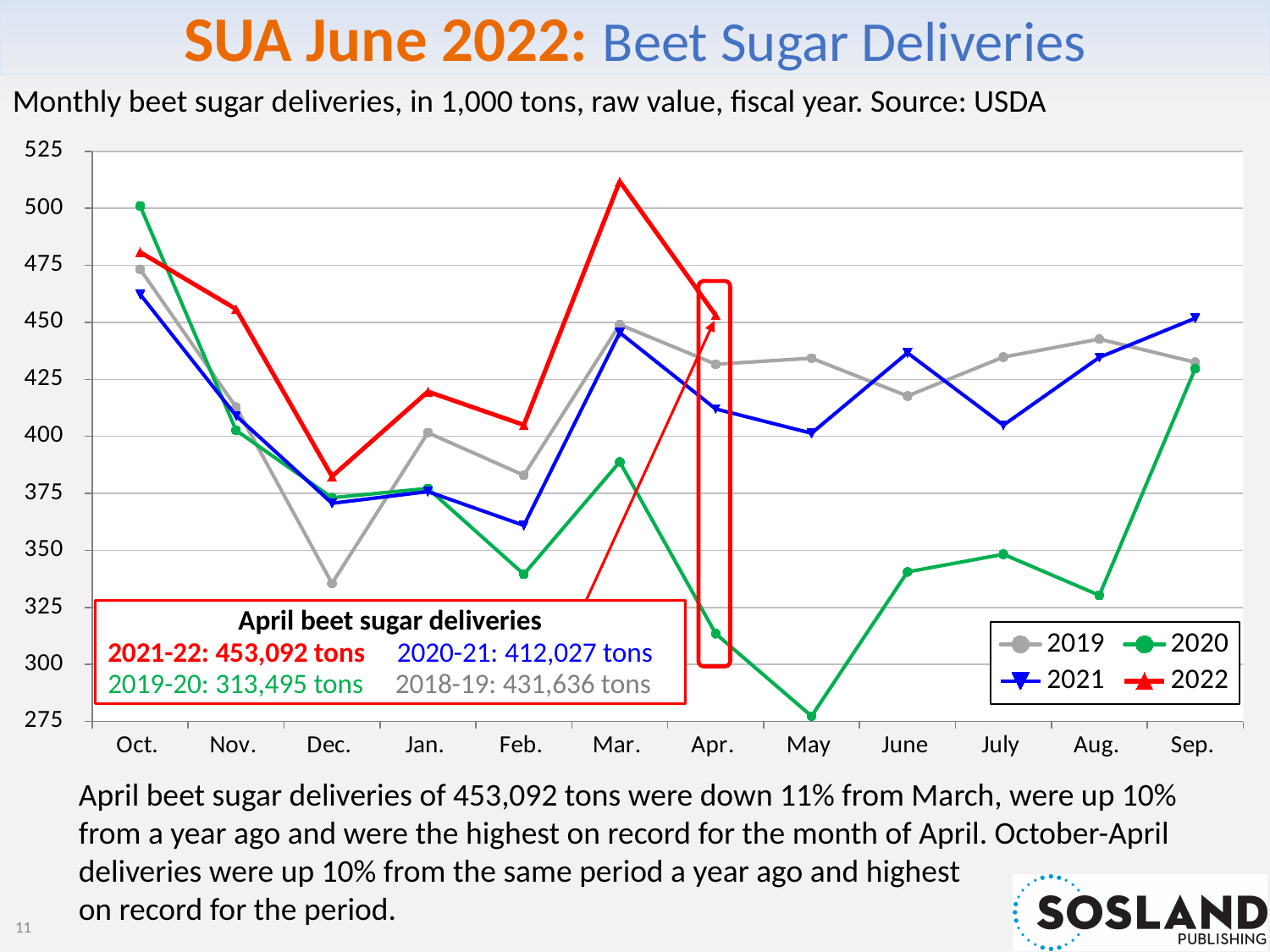
In which month does the 2020 series reach its lowest value? May Is the value for the 2022 series in March greater or less than 500? greater According to the annotation box, what were April beet sugar deliveries in 2021-22? 453,092 tons Does the 2022 series rise or fall from October to December? fall According to the annotation box, what were April beet sugar deliveries in 2019-20? 313,495 tons What kind of chart is shown on the slide? line chart In October, which series has the higher value, 2020 or 2021? 2020 Using the annotation box, how much larger were April deliveries in 2021-22 than in 2020-21? 41,065 tons Which series has the highest value in March? 2022 How many months are shown along the x axis of the chart? 12 Is the value for the 2020 series in May greater or less than 300? less How many series does the chart legend list? 4